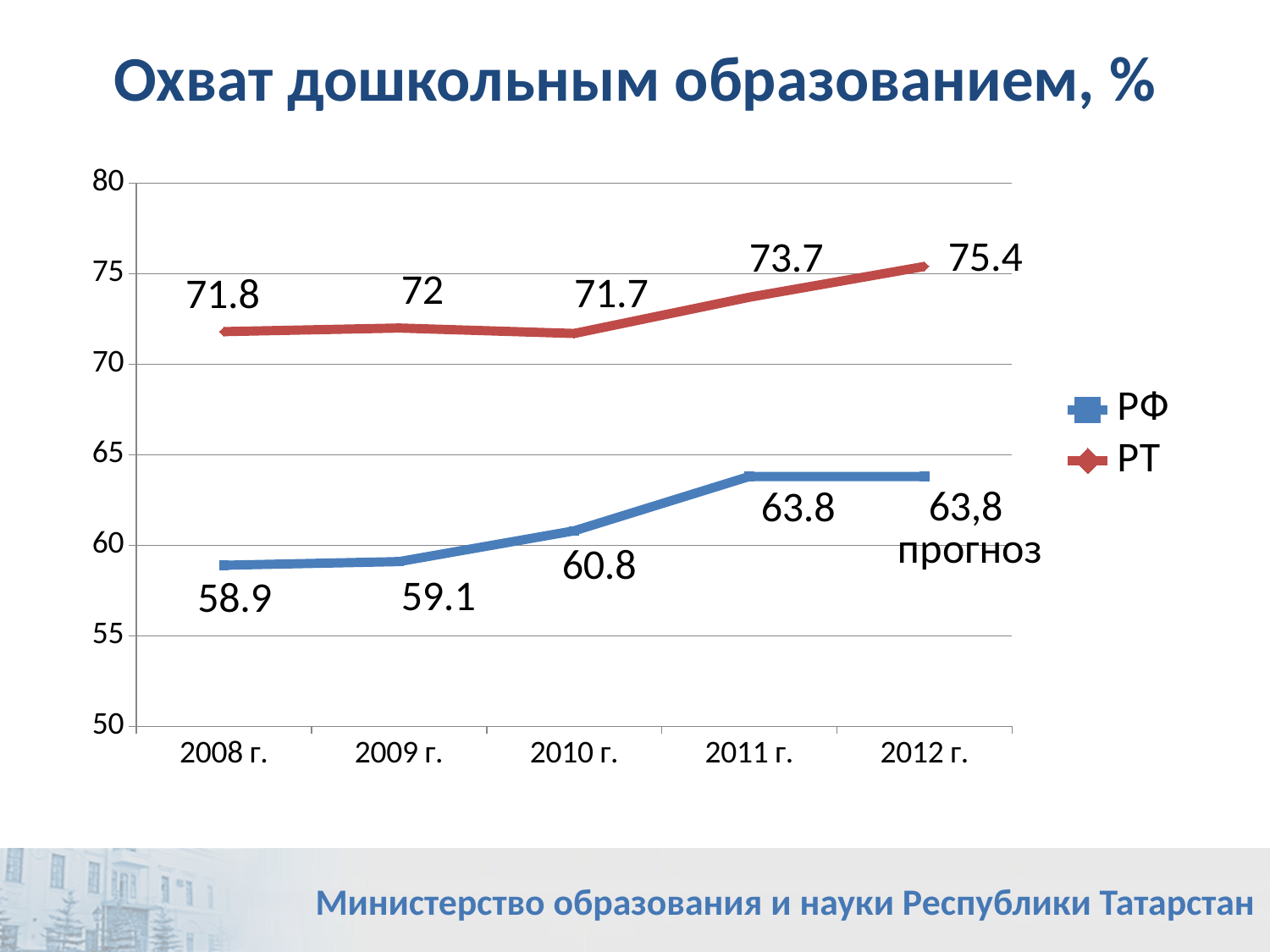
Is the value for РФ in 2011 г. greater or less than 65? less In which year is the РТ series highest? 2012 г. How many series does the legend list? 2 How many years are shown on the x axis? 5 Which series has the larger value in 2010 г., РФ or РТ? РТ What is the value for РТ in 2009 г.? 72 What is the value for РФ in 2008 г.? 58.9 What is the value for РТ in 2011 г.? 73.7 In which year is the РФ series lowest? 2008 г. What is the difference between РТ and РФ in 2011 г.? 9.9 What is the value for РФ in 2010 г.? 60.8 What kind of chart is shown on the slide? line chart